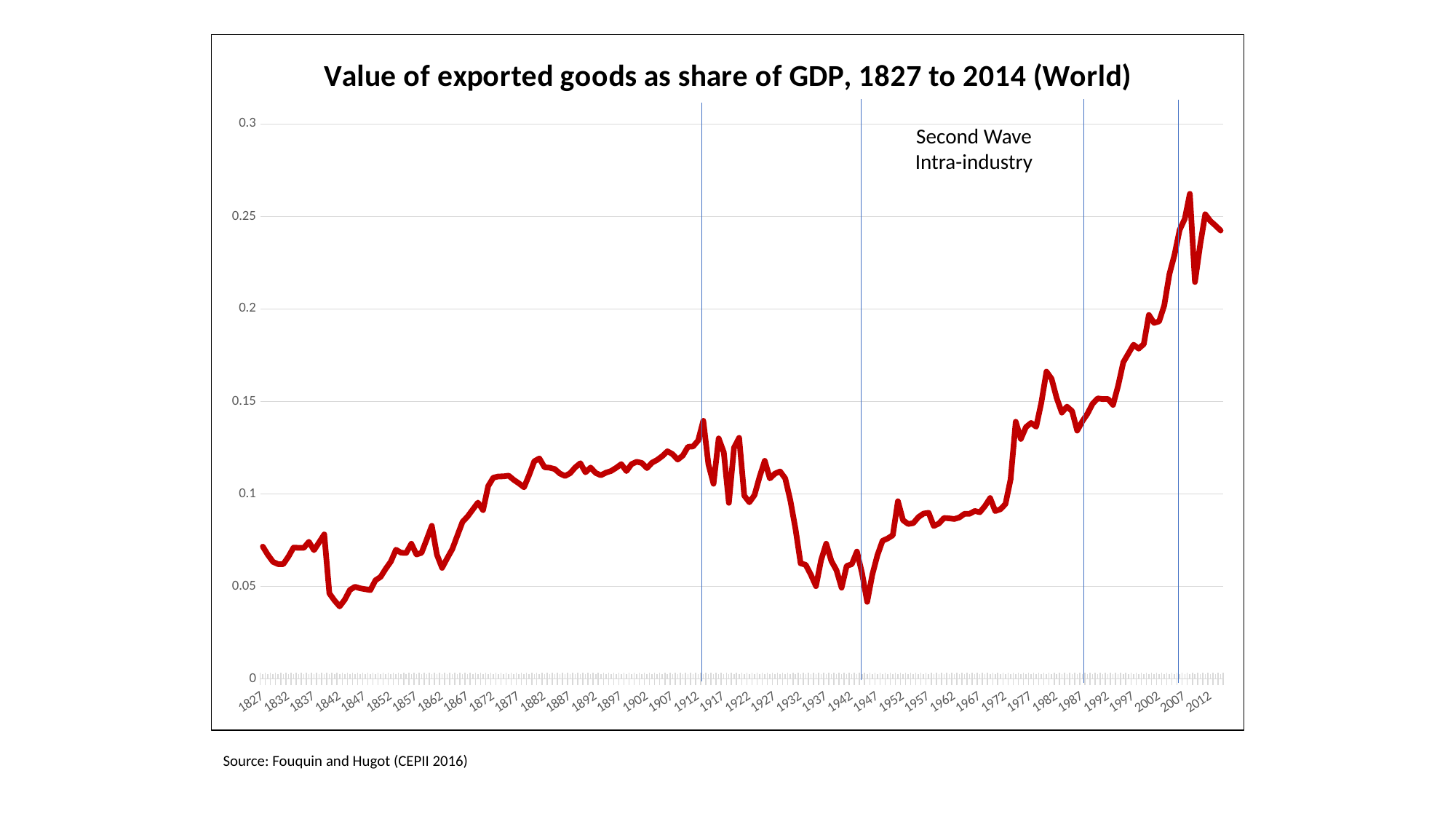
Is the value for 2007 greater or less than 0.2? greater What does the text annotation inside the chart say? Second Wave Intra-industry Is the value for 1827 greater or less than 0.1? less Is the value for 1912 greater or less than 0.1? greater What kind of chart is shown on the slide? line chart Does the value generally rise or fall between 1972 and 2007? rise What is the title of the chart? Value of exported goods as share of GDP, 1827 to 2014 (World) How many data series are plotted in the chart? 1